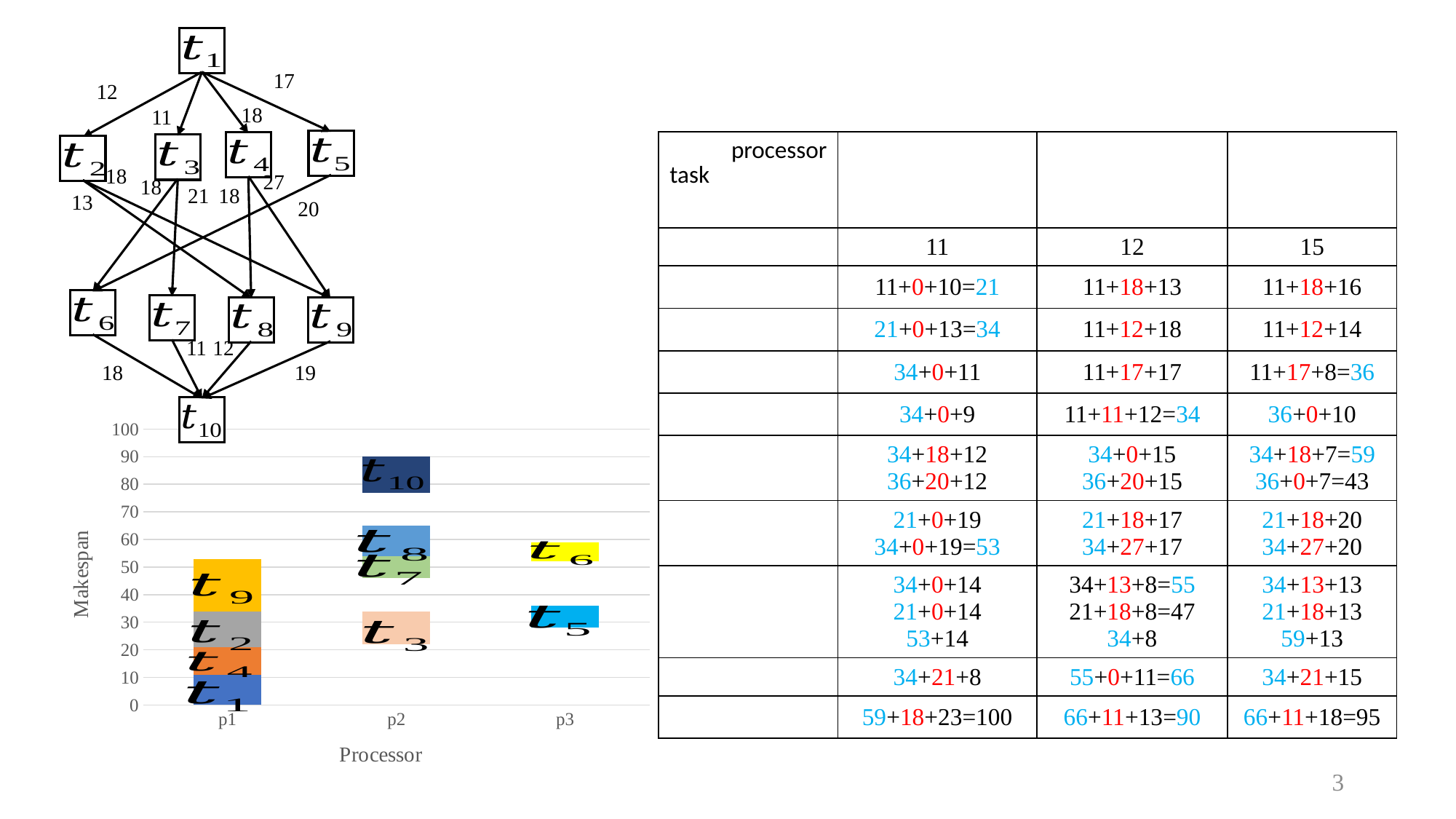
How many task blocks are stacked on processor p3 in the bar chart? 2 What is the title of the x axis of the bar chart? Processor Which task block is at the bottom of the p1 stack in the bar chart? t1 What is the title of the y axis of the bar chart? Makespan How many processor categories are shown on the x axis of the bar chart? 3 Is the top of the t10 block on p2 greater or less than 70? greater How many task blocks are stacked on processor p1 in the bar chart? 4 Is the top of the t6 block on p3 greater or less than 50? greater What kind of chart is shown at the bottom left of the slide? bar chart Is the top of the t9 block on p1 greater or less than 60? less Which processor's stack reaches the highest makespan in the bar chart? p2